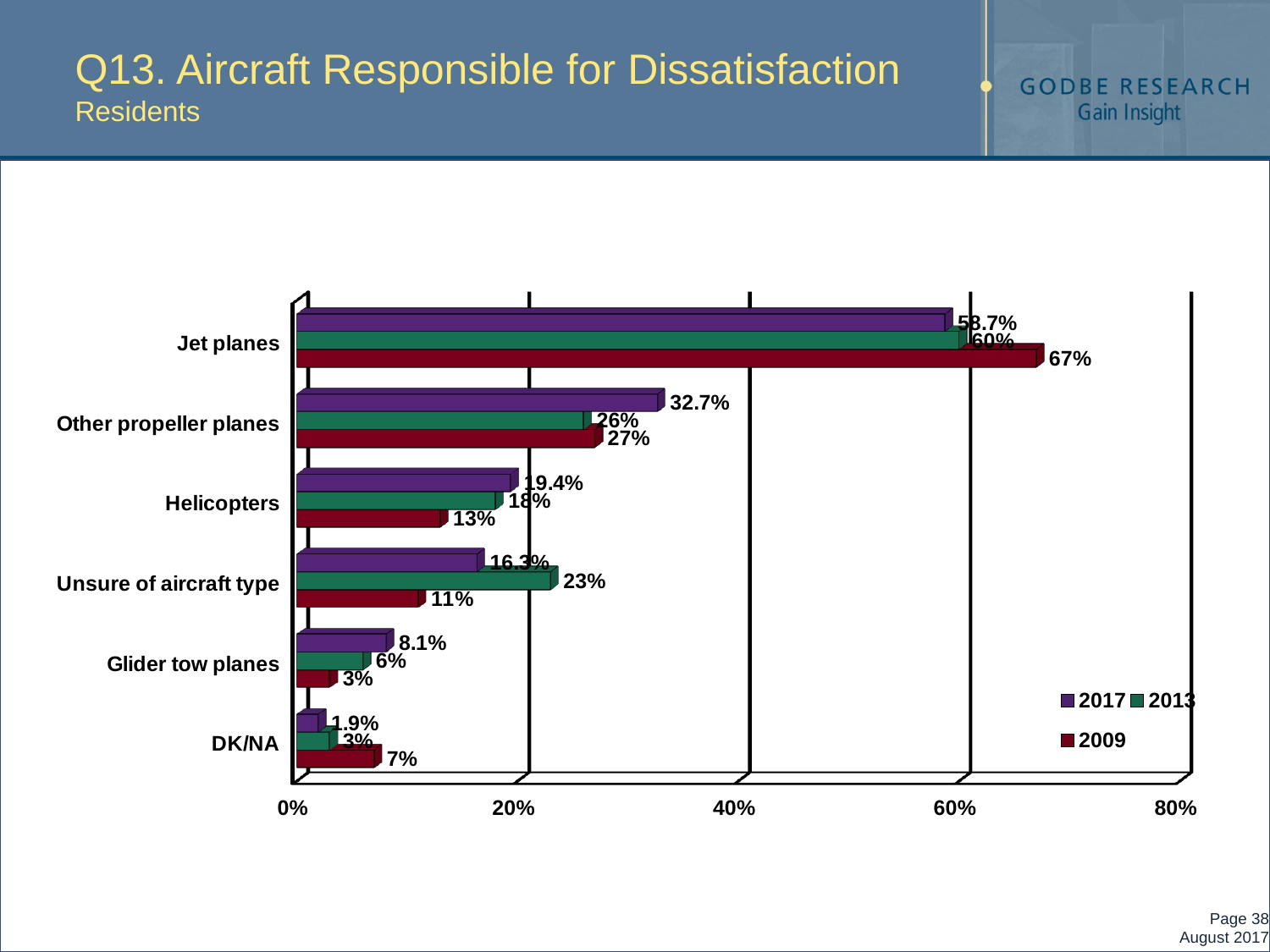
What is the difference between the 2009 and 2013 values for Jet planes? 7% What is the 2009 value for DK/NA? 7% What is the 2009 value for Jet planes? 67% Which category has the lowest 2017 value? DK/NA How many aircraft categories are shown on the chart? 6 What kind of chart is shown on the slide? bar chart Which year is shown in purple in the legend? 2017 What is the 2013 value for Unsure of aircraft type? 23% For Helicopters, which is larger: the 2017 value or the 2009 value? 2017 What is the 2017 value for Other propeller planes? 32.7% How many series does the legend list? 3 Which category has the highest 2009 value? Jet planes